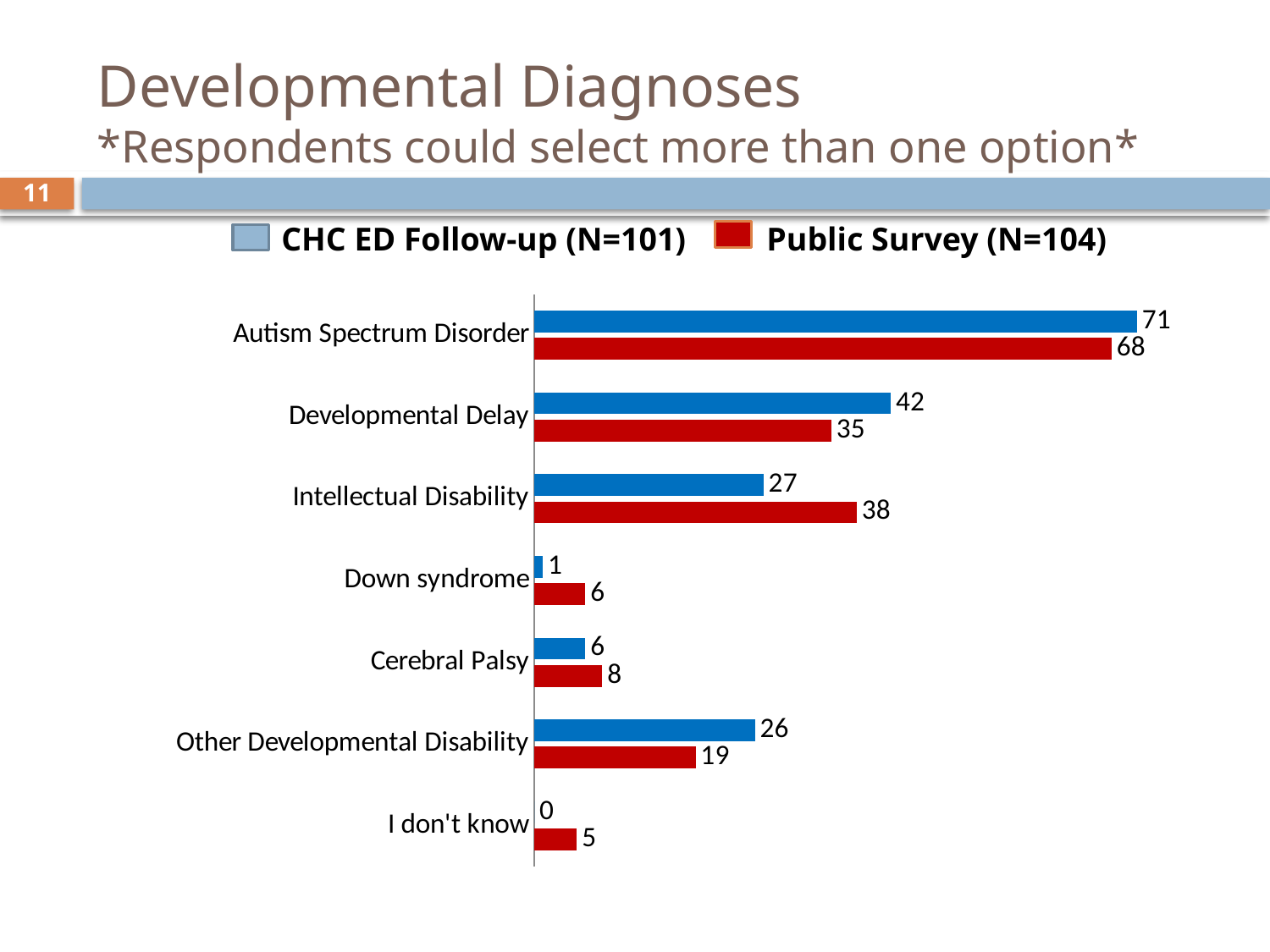
Which is larger for Other Developmental Disability: the CHC ED Follow-up value or the Public Survey value? CHC ED Follow-up What is the Public Survey value for Intellectual Disability? 38 What kind of chart is shown on the slide? Bar chart What is the Public Survey value for I don't know? 5 Which category has the lowest CHC ED Follow-up value? I don't know What is the difference between the CHC ED Follow-up and Public Survey values for Developmental Delay? 7 Which category has the highest Public Survey value? Autism Spectrum Disorder Which is larger for Intellectual Disability: the CHC ED Follow-up value or the Public Survey value? Public Survey What is the sample size (N) for the Public Survey series in the legend? N=104 How many series does the legend list? 2 How many categories are shown on the chart? 7 What is the CHC ED Follow-up value for Autism Spectrum Disorder? 71